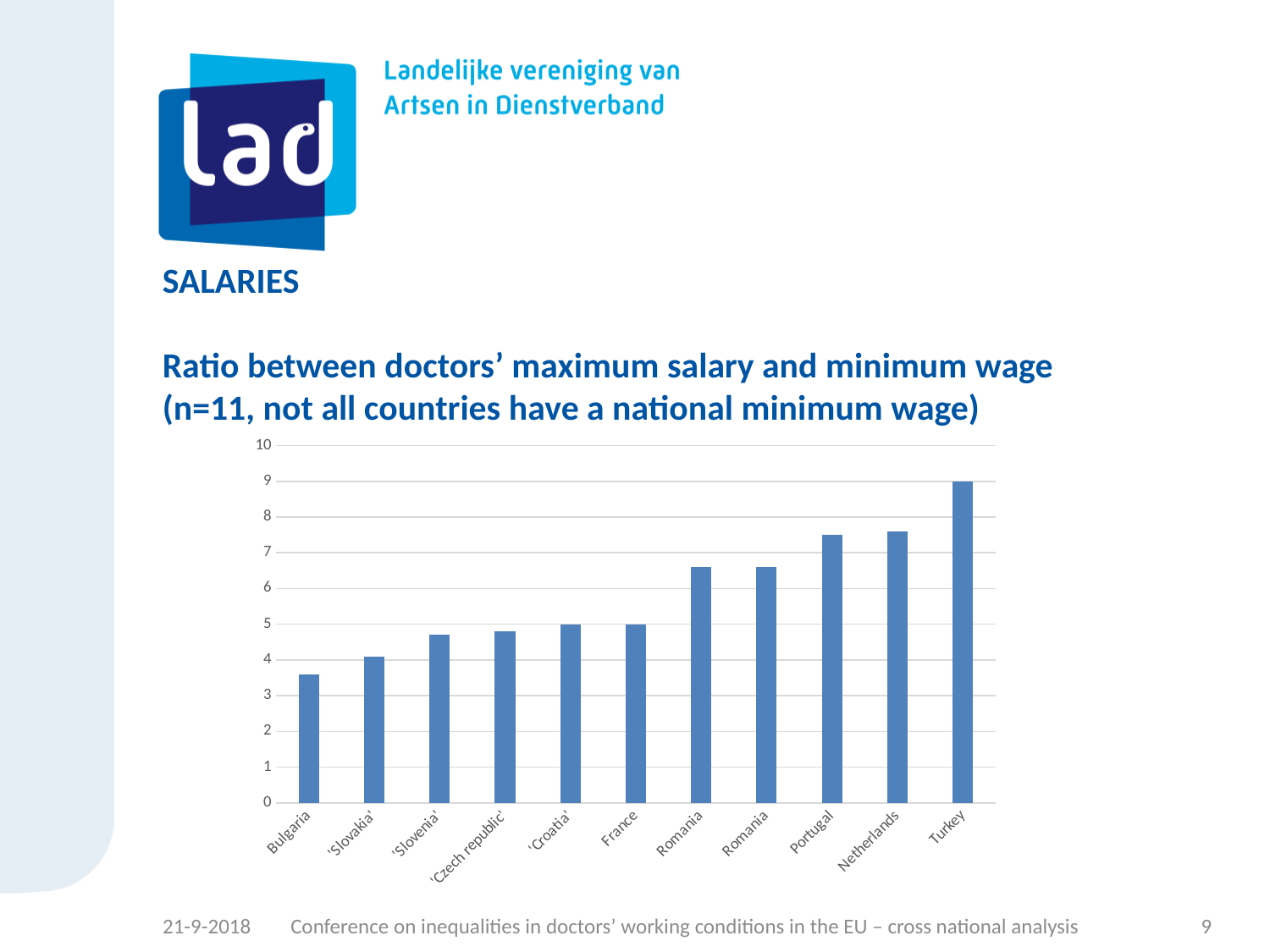
How many countries (bars) are shown in the chart? 11 Which has a higher ratio, Turkey or Netherlands? Turkey Is the value for Netherlands greater or less than 8? less Which country has the lowest ratio between doctors' maximum salary and minimum wage? Bulgaria Is the value for Bulgaria greater or less than 4? less Which country has the highest ratio between doctors' maximum salary and minimum wage? Turkey Do the values generally rise or fall from left to right along the x axis? rise Is the value for Portugal greater or less than 7? greater Which country label appears twice on the x axis of the chart? Romania What kind of chart is shown on the slide? bar chart What is the ratio value for Turkey? 9